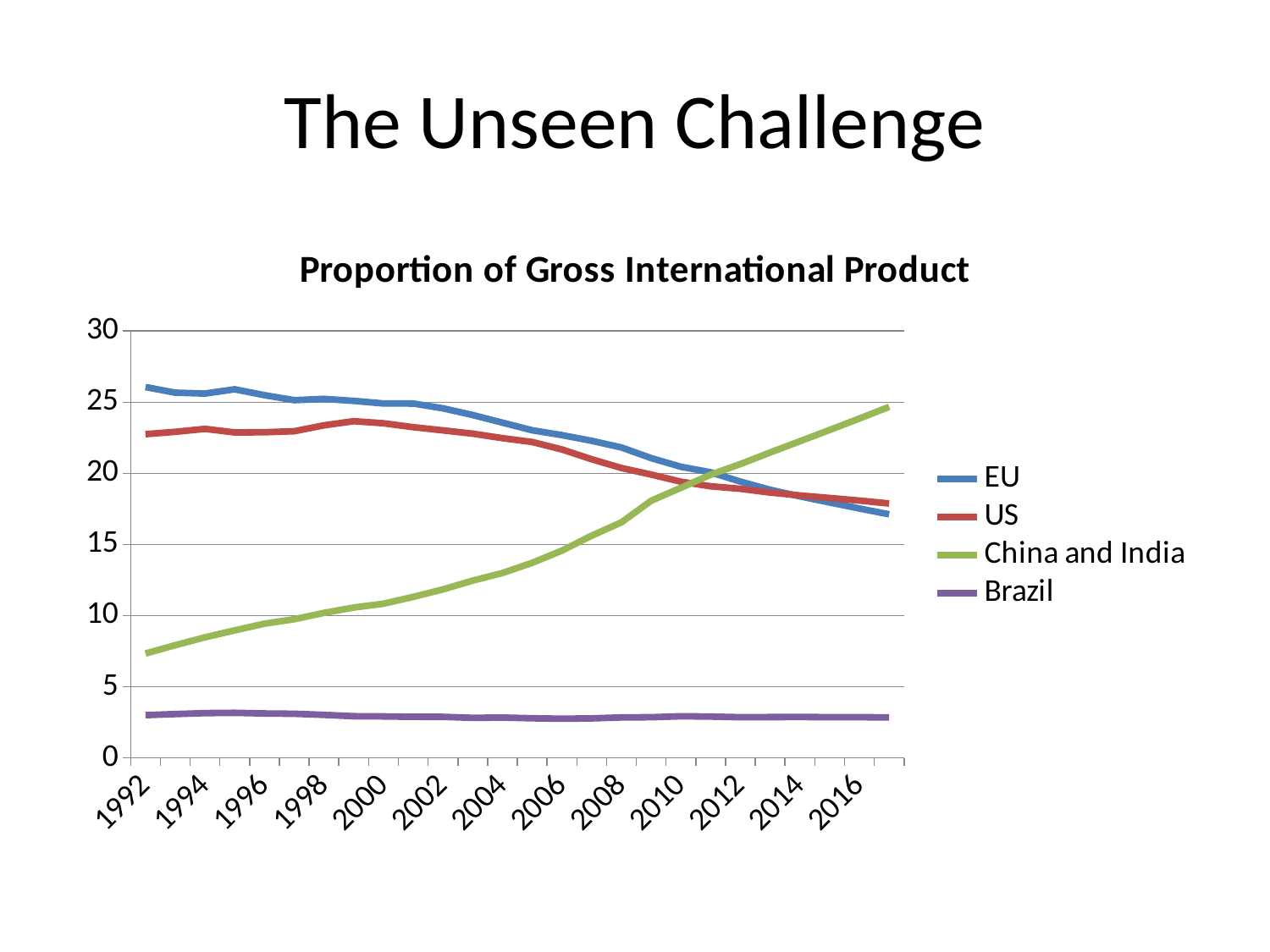
What kind of chart is shown on the slide? line chart Which series has the highest value in 1992? EU Does the China and India line rise or fall from 1992 to 2016? rise What is the title of the chart? Proportion of Gross International Product Is the value for China and India in 1992 greater or less than 10? less Which series is shown in green in the legend? China and India Which series has the highest value in 2016? China and India How many series does the legend list? 4 Does the EU line rise or fall from 1992 to 2016? fall Is the value for EU in 1992 greater or less than 25? greater Which series has the lowest value throughout the chart? Brazil In 2016, which is larger, the value for US or the value for China and India? China and India